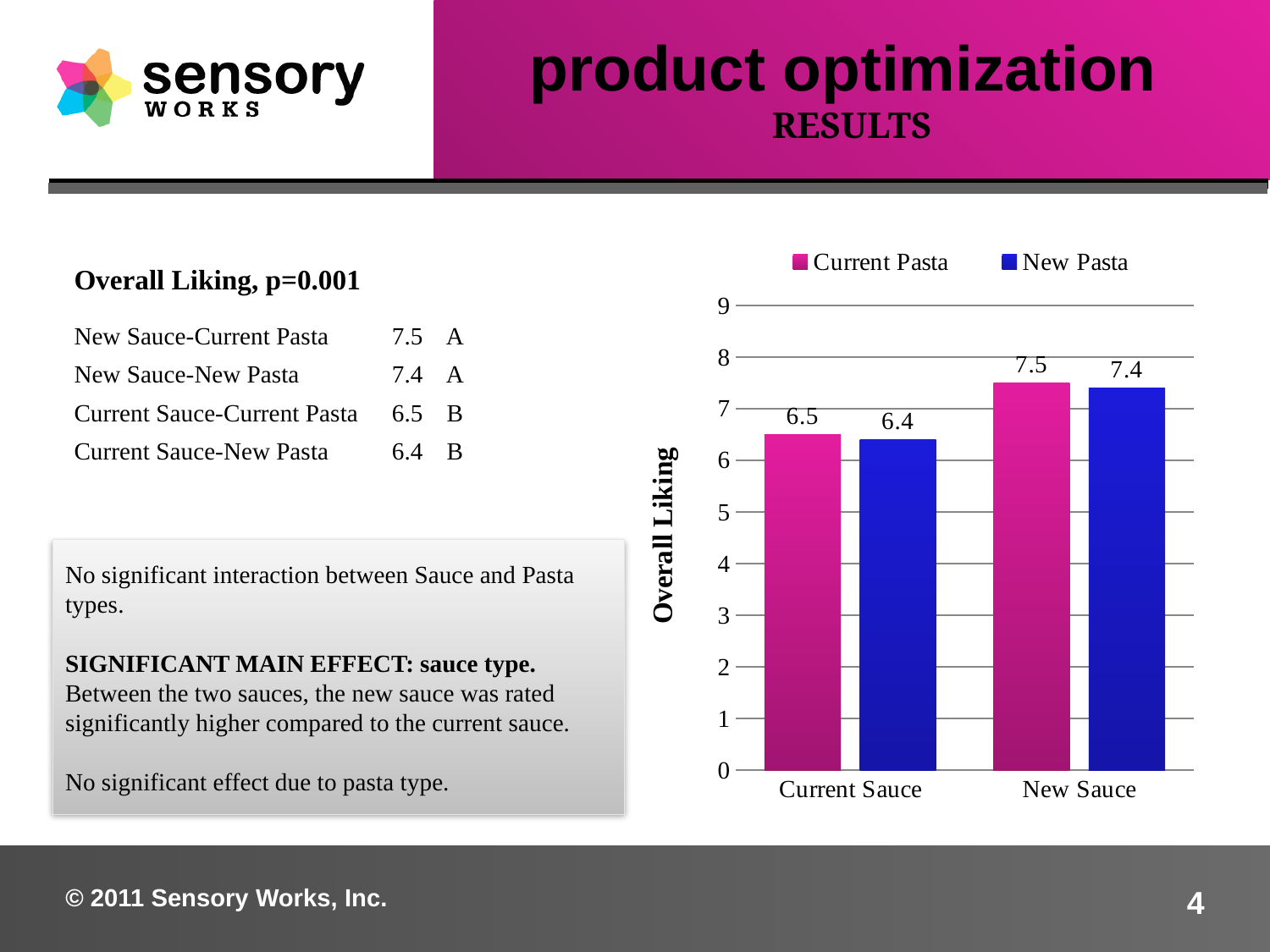
Which bar has the lowest Overall Liking value? New Pasta, Current Sauce What is the difference between the Current Pasta values for New Sauce and Current Sauce? 1.0 What is the Overall Liking value for New Pasta with New Sauce? 7.4 What is the difference between the New Pasta values for New Sauce and Current Sauce? 1.0 What is the Overall Liking value for Current Pasta with Current Sauce? 6.5 How many sauce categories are shown on the x axis? 2 Which is larger: the Current Pasta value for Current Sauce or the Current Pasta value for New Sauce? New Sauce What is the label of the vertical axis of the chart? Overall Liking What kind of chart is shown on the slide? Bar chart What is the Overall Liking value for New Pasta with Current Sauce? 6.4 How many series does the legend list? 2 Which bar has the highest Overall Liking value? Current Pasta, New Sauce